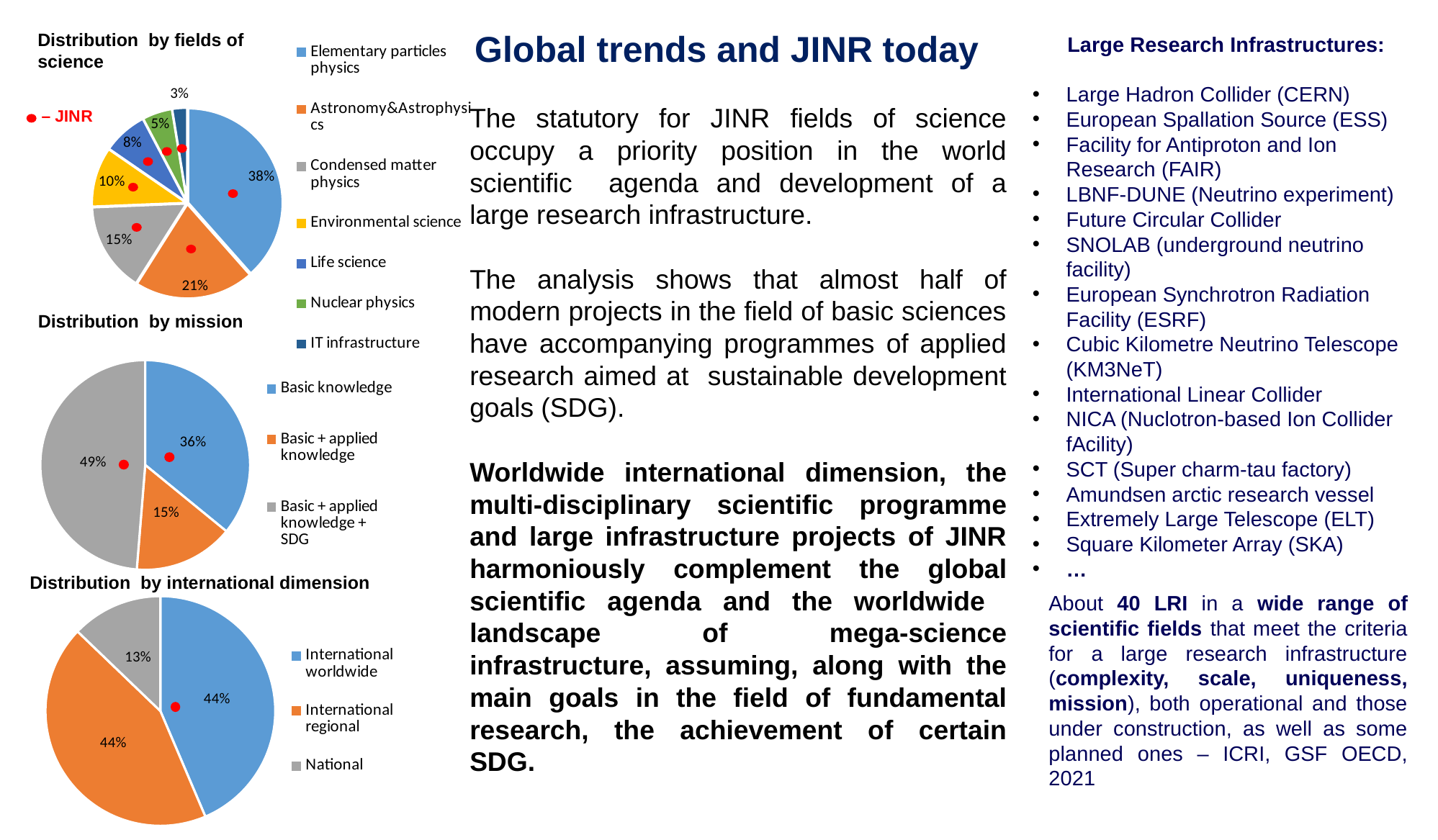
In the 'Distribution by international dimension' chart, what share does National have? 13% In the 'Distribution by fields of science' chart, how many fields are shown? 7 In the 'Distribution by fields of science' chart, which field has the smallest share? IT infrastructure What type of chart is the 'Distribution by international dimension' chart? Pie chart In the 'Distribution by international dimension' chart, what share does International regional have? 44% In the 'Distribution by mission' chart, which category has the largest share? Basic + applied knowledge + SDG How many categories does the legend of the 'Distribution by mission' chart list? 3 In the 'Distribution by fields of science' chart, what is the difference between the shares of Astronomy&Astrophysics and Life science? 13% In the 'Distribution by fields of science' chart, what share does Condensed matter physics have? 15% In the 'Distribution by mission' chart, what share does Basic + applied knowledge + SDG have? 49% In the 'Distribution by mission' chart, which is larger: Basic knowledge or Basic + applied knowledge? Basic knowledge In the 'Distribution by fields of science' chart, what share does Elementary particles physics have? 38%